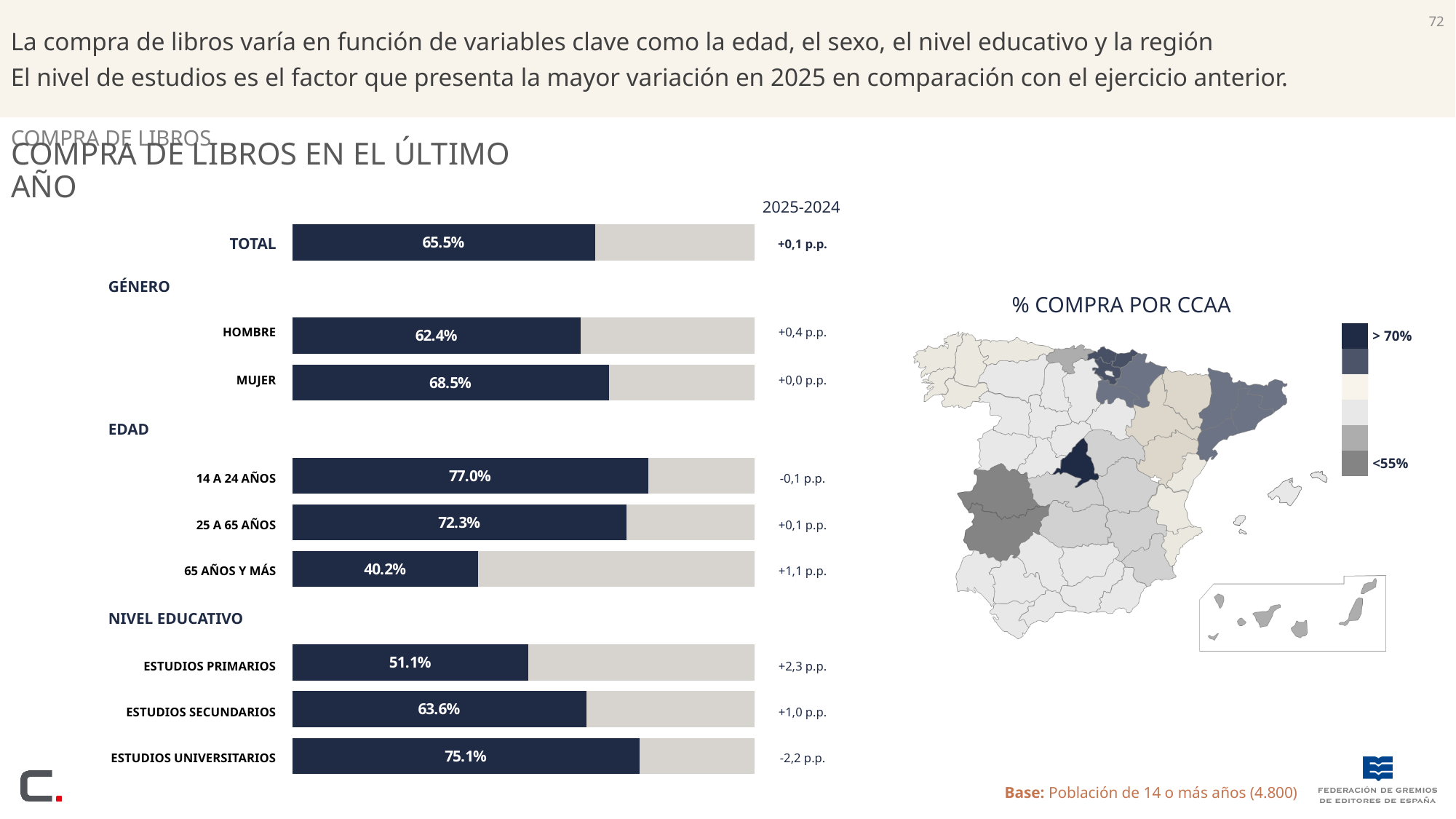
What kind of chart is 'COMPRA DE LIBROS EN EL ÚLTIMO AÑO'? Bar chart In the bar chart 'COMPRA DE LIBROS EN EL ÚLTIMO AÑO', which is larger, the value for ESTUDIOS PRIMARIOS or ESTUDIOS SECUNDARIOS? ESTUDIOS SECUNDARIOS In the bar chart 'COMPRA DE LIBROS EN EL ÚLTIMO AÑO', what is the 2025-2024 change shown for ESTUDIOS UNIVERSITARIOS? -2,2 p.p. In the bar chart 'COMPRA DE LIBROS EN EL ÚLTIMO AÑO', which category has the lowest value? 65 AÑOS Y MÁS How many category bars are plotted in the bar chart 'COMPRA DE LIBROS EN EL ÚLTIMO AÑO'? 9 In the bar chart 'COMPRA DE LIBROS EN EL ÚLTIMO AÑO', what is the value for TOTAL? 65.5% In the bar chart 'COMPRA DE LIBROS EN EL ÚLTIMO AÑO', what is the difference between the values for MUJER and HOMBRE? 6.1 percentage points In the bar chart 'COMPRA DE LIBROS EN EL ÚLTIMO AÑO', what is the value for 65 AÑOS Y MÁS? 40.2% In the bar chart 'COMPRA DE LIBROS EN EL ÚLTIMO AÑO', which category has the highest value? 14 A 24 AÑOS In the bar chart 'COMPRA DE LIBROS EN EL ÚLTIMO AÑO', what is the value for MUJER? 68.5% In the bar chart 'COMPRA DE LIBROS EN EL ÚLTIMO AÑO', what is the value for ESTUDIOS UNIVERSITARIOS? 75.1% In the bar chart 'COMPRA DE LIBROS EN EL ÚLTIMO AÑO', what is the 2025-2024 change shown for ESTUDIOS PRIMARIOS? +2,3 p.p.